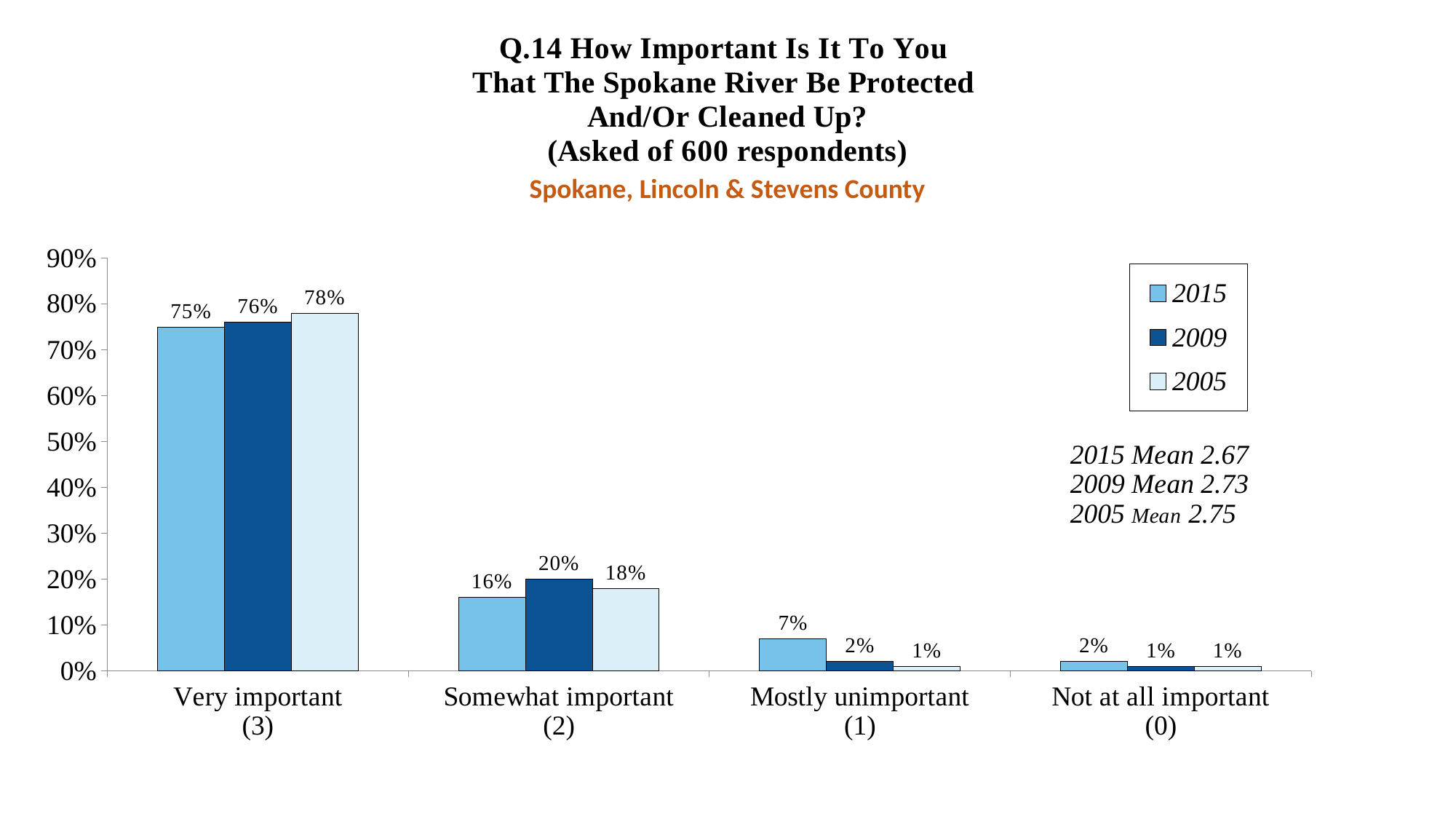
Which is larger for 'Mostly unimportant': the 2015 value or the 2009 value? 2015 How many response categories are shown on the x axis? 4 Which category has the lowest value for the 2015 series? Not at all important (0) What percentage of respondents in 2015 said protecting the Spokane River is very important? 75% Is the 2009 value for 'Very important' greater or less than 70%? greater What is the difference between the 2005 and 2015 values for 'Very important'? 3% What kind of chart is shown on the slide? Bar chart What is the 2009 value for the 'Somewhat important' category? 20% How many series does the legend list? 3 What is the 2005 value for 'Mostly unimportant'? 1% What is the 2009 mean shown on the slide? 2.73 Which category has the highest value for the 2005 series? Very important (3)